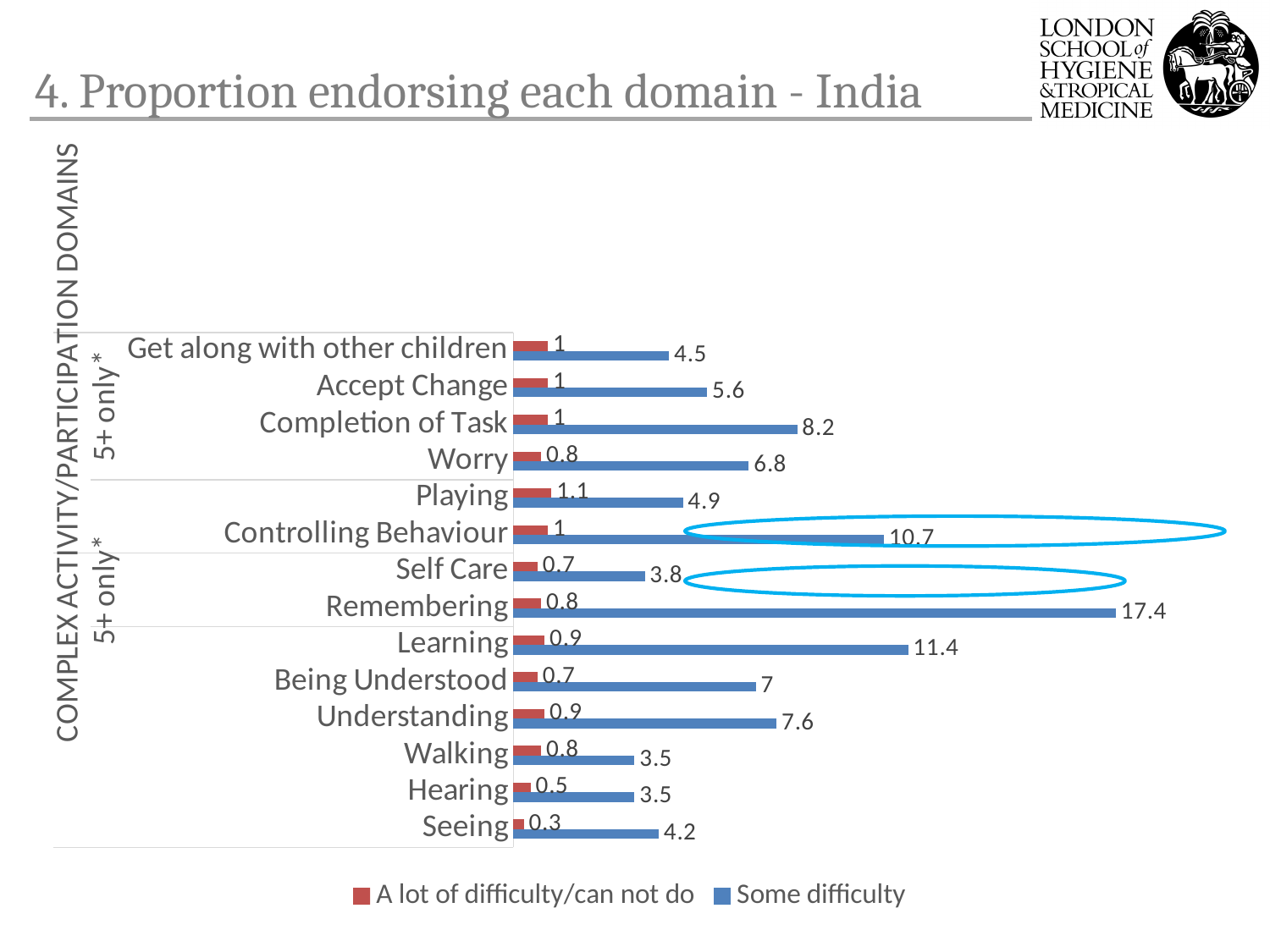
What is the 'Some difficulty' value for Controlling Behaviour? 10.7 Which has a larger 'Some difficulty' value, Worry or Accept Change? Worry Which colour represents the 'Some difficulty' series? Blue Which domain has the lowest 'A lot of difficulty/can not do' value? Seeing What is the difference between the 'Some difficulty' values for Learning and Completion of Task? 3.2 Which domain has the highest 'Some difficulty' value? Remembering What is the 'A lot of difficulty/can not do' value for Seeing? 0.3 What type of chart is shown on the slide? Bar chart How many series does the legend list? 2 How many domains are shown on the chart? 14 What is the 'Some difficulty' value for Remembering? 17.4 What is the 'A lot of difficulty/can not do' value for Playing? 1.1